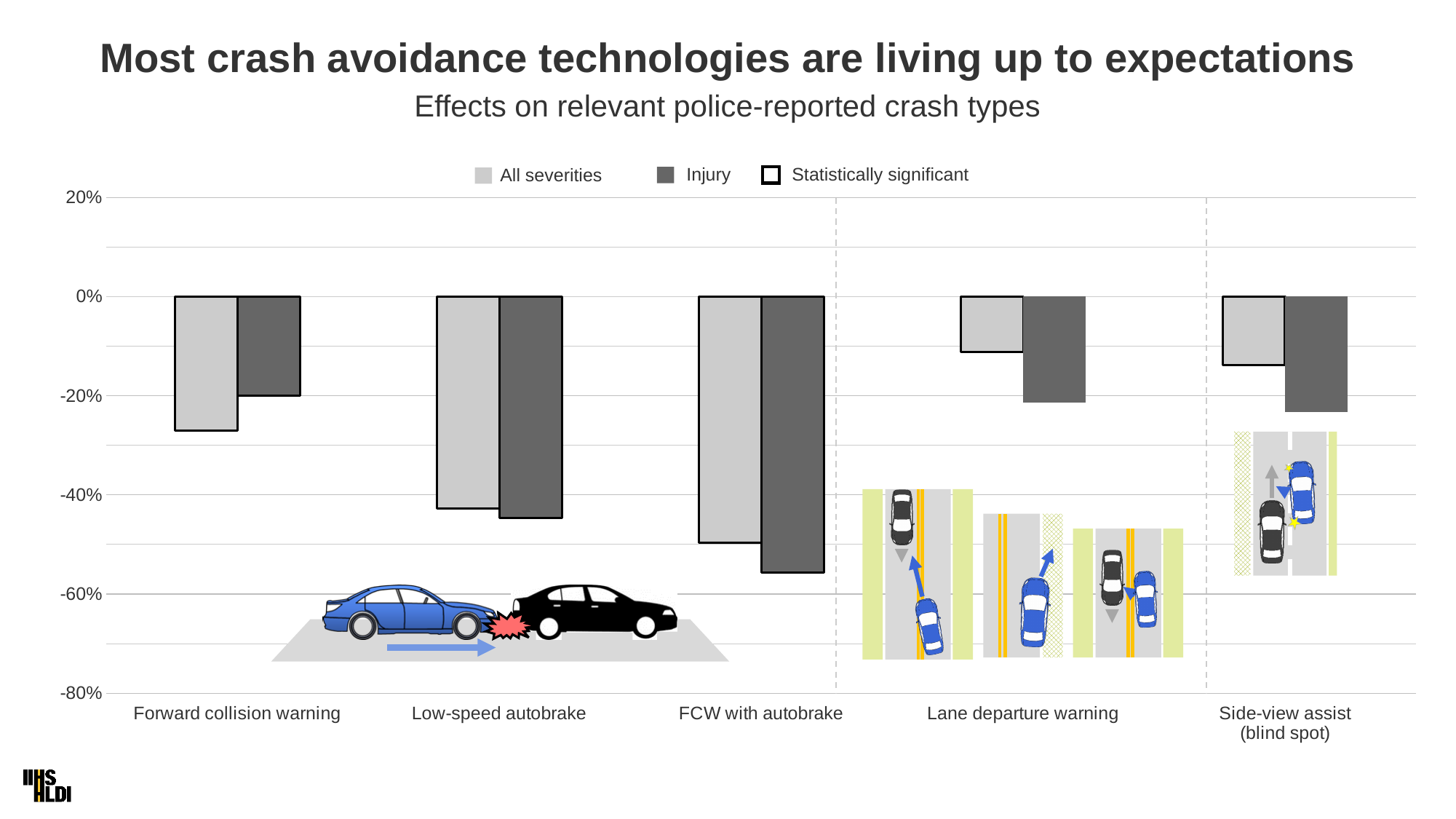
Which technology shows the largest reduction (most negative value) for Injury crashes? FCW with autobrake Which technology shows the smallest reduction for All severities? Lane departure warning Is the Injury value for Low-speed autobrake greater or less than -40%? less How many bar series are plotted for each technology? 2 Is the All severities value for FCW with autobrake greater or less than -40%? less What is the subtitle of the chart? Effects on relevant police-reported crash types For Lane departure warning, which series shows the larger reduction, All severities or Injury? Injury Is the All severities value for Lane departure warning greater or less than -20%? greater For Forward collision warning, which series shows the larger reduction, All severities or Injury? All severities What kind of chart is shown on the slide? Bar chart How many crash avoidance technologies are shown on the x axis? 5